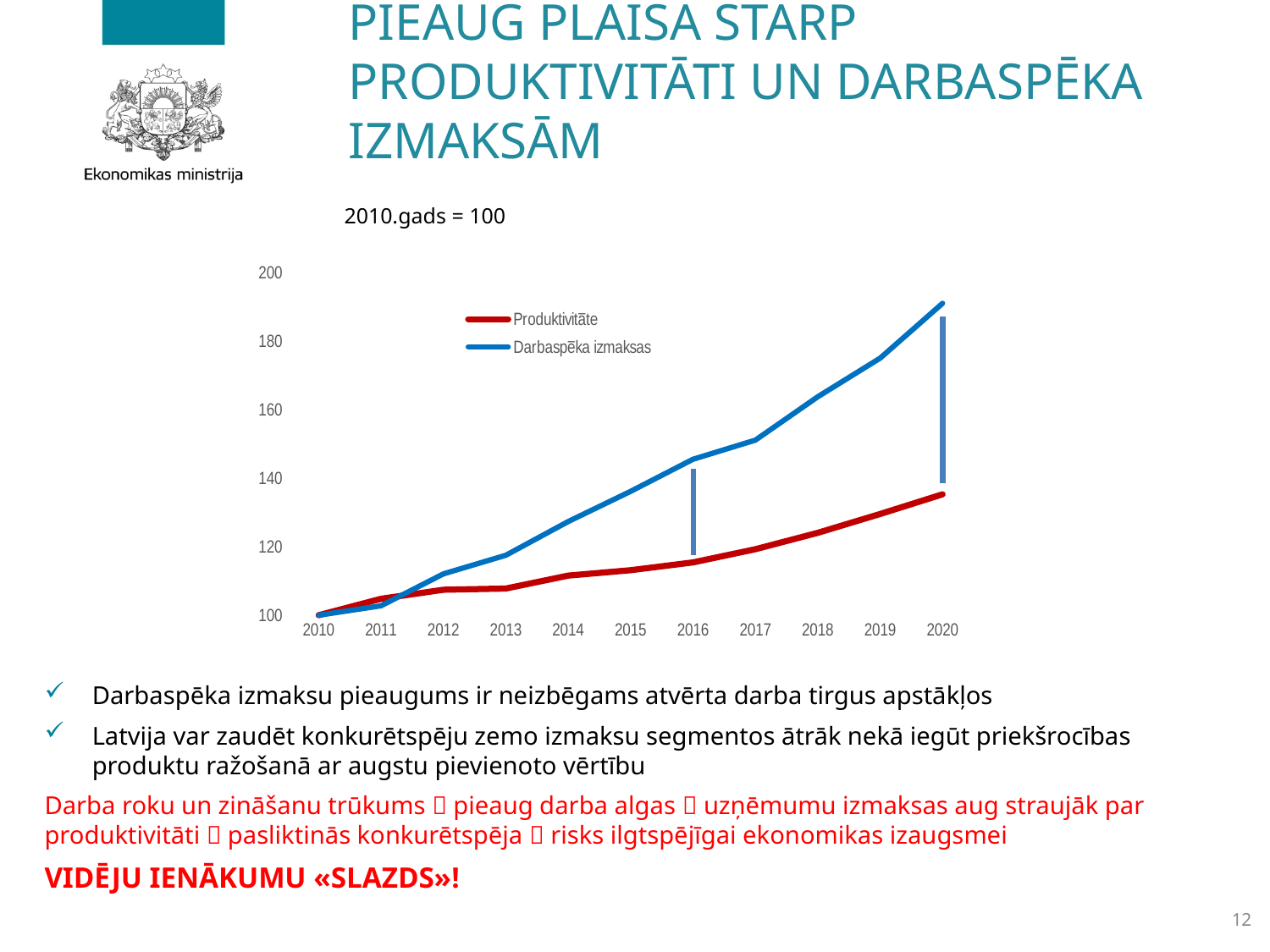
In 2020, which series has the larger value, Produktivitāte or Darbaspēka izmaksas? Darbaspēka izmaksas Does the Produktivitāte series rise or fall from 2010 to 2020? rise In which year does the Darbaspēka izmaksas series reach its highest value? 2020 How many series does the chart legend list? 2 Is the value for Produktivitāte in 2016 greater or less than 120? less What kind of chart is shown on the slide? line chart Is the value for Produktivitāte in 2020 greater or less than 140? less What base year and value does the chart's subtitle state for the index? 2010.gads = 100 Is the value for Darbaspēka izmaksas in 2020 greater or less than 180? greater Does the Darbaspēka izmaksas series rise or fall from 2010 to 2020? rise How many years are shown on the x axis of the chart? 11 Which two series are listed in the chart legend? Produktivitāte and Darbaspēka izmaksas